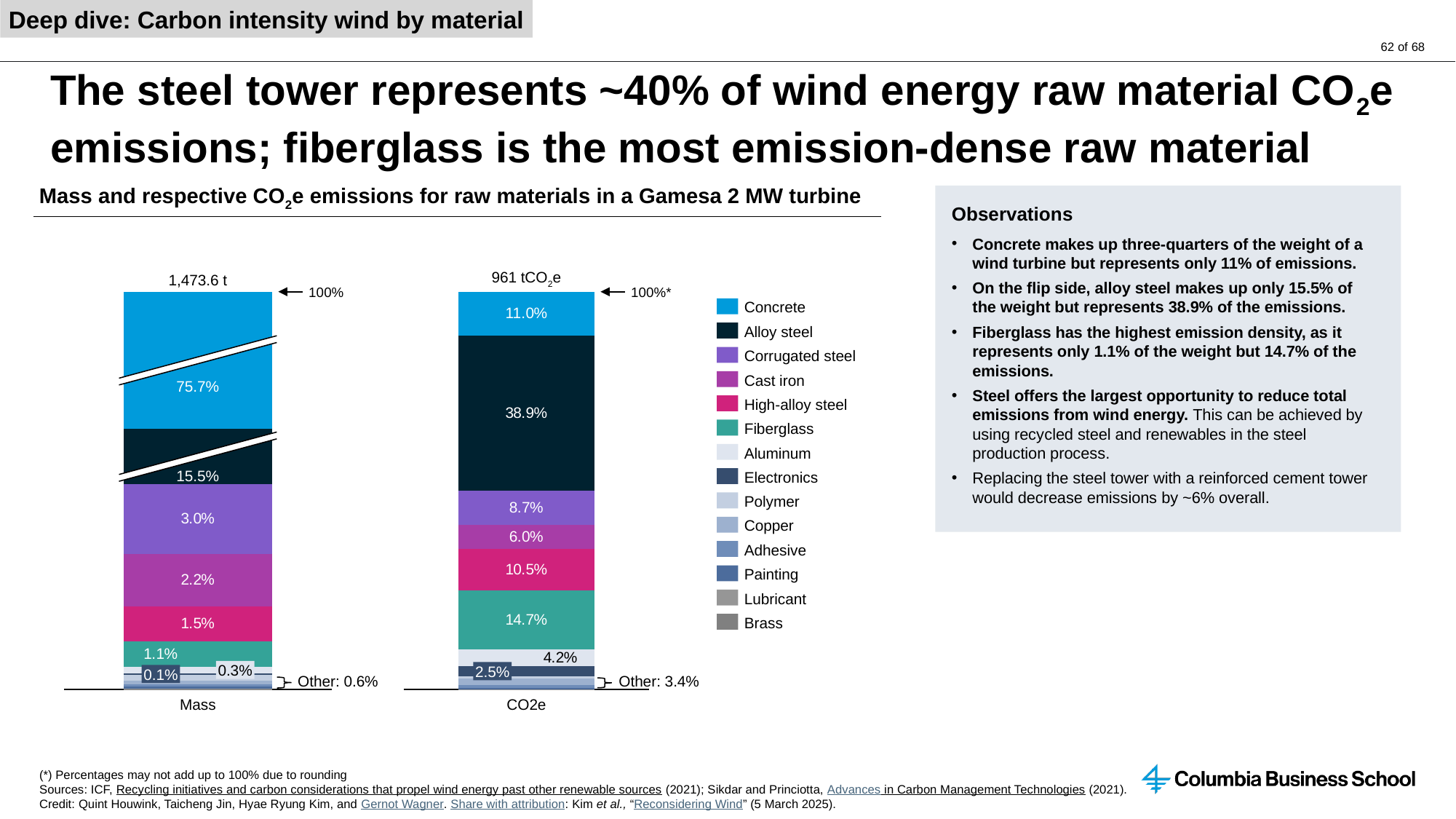
What is the total CO2e shown above the CO2e bar? 961 tCO2e What share of CO2e emissions does fiberglass represent? 14.7% Which material has the largest share of the CO2e bar? Alloy steel Which is larger: the high-alloy steel share of CO2e or the cast iron share of CO2e? High-alloy steel How many materials are listed in the legend? 14 What is the 'Other' share shown for the CO2e bar? 3.4% What share of CO2e emissions does alloy steel represent in the CO2e bar? 38.9% Which material has the largest share of the Mass bar? Concrete What type of chart is shown on the slide? Stacked bar chart What is the total mass shown above the Mass bar? 1,473.6 t What share of the mass does concrete represent in the Mass bar? 75.7% What is the difference between the alloy steel share of CO2e (38.9%) and its share of mass (15.5%)? 23.4%